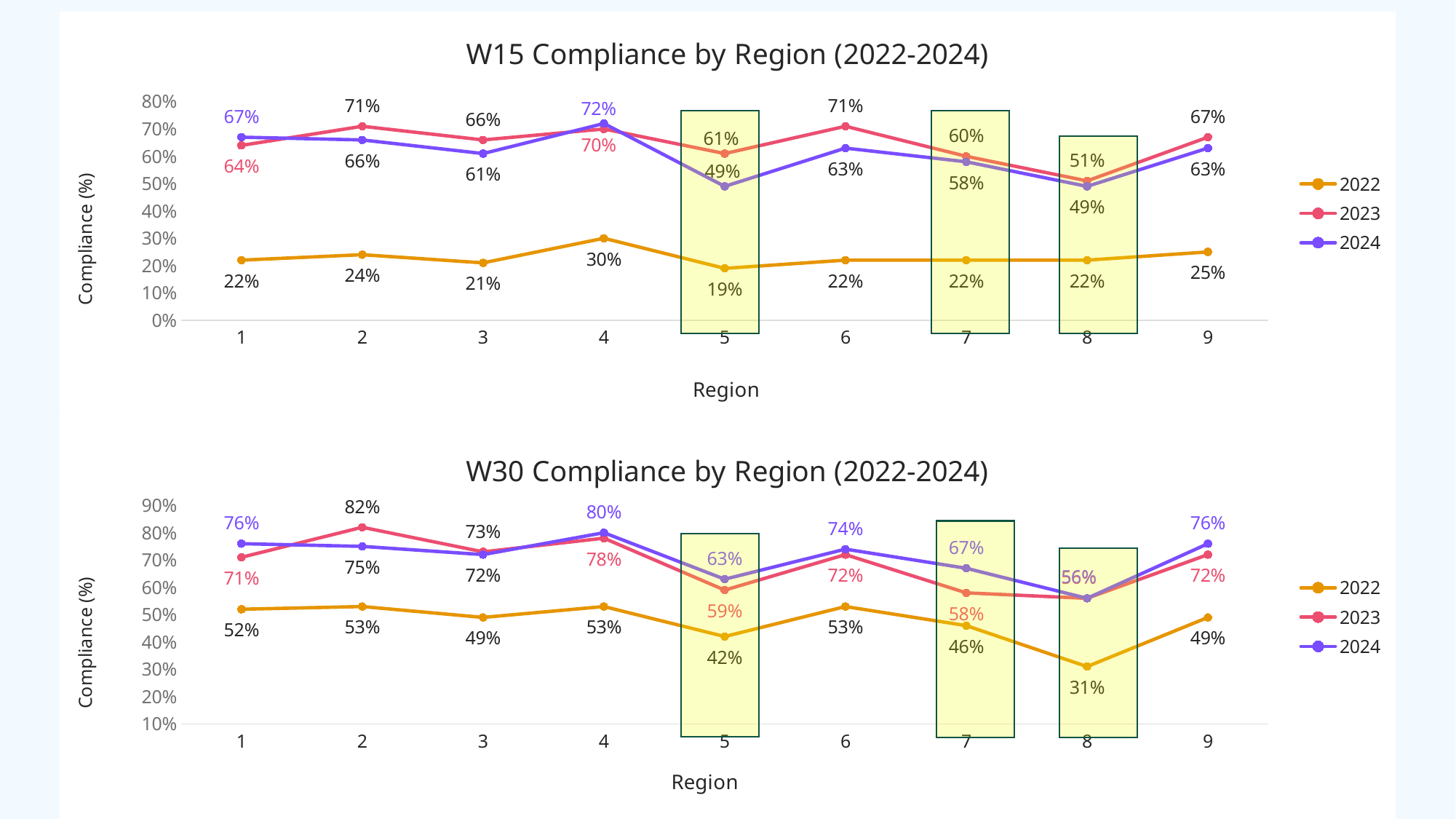
In the W30 Compliance by Region chart, what is the 2022 compliance value for Region 8? 31% What type of chart is the W30 Compliance by Region chart? Line chart In the W15 Compliance by Region chart, which region has the lowest 2022 compliance value? Region 5 In the W15 Compliance by Region chart, what is the 2024 compliance value for Region 5? 49% How many series does the legend of the W15 Compliance by Region chart list? 3 In the W15 Compliance by Region chart, which is larger for Region 1: the 2023 value or the 2024 value? 2024 In the W30 Compliance by Region chart, what is the 2023 compliance value for Region 2? 82% In the W30 Compliance by Region chart, which region has the highest 2024 compliance value? Region 4 In the W30 Compliance by Region chart, what is the difference between the 2024 and 2022 values for Region 7? 21% In the W15 Compliance by Region chart, what is the 2022 compliance value for Region 4? 30% How many regions are shown on the x axis of the W30 Compliance by Region chart? 9 In the W15 Compliance by Region chart, what is the difference between the 2023 and 2024 values for Region 5? 12%